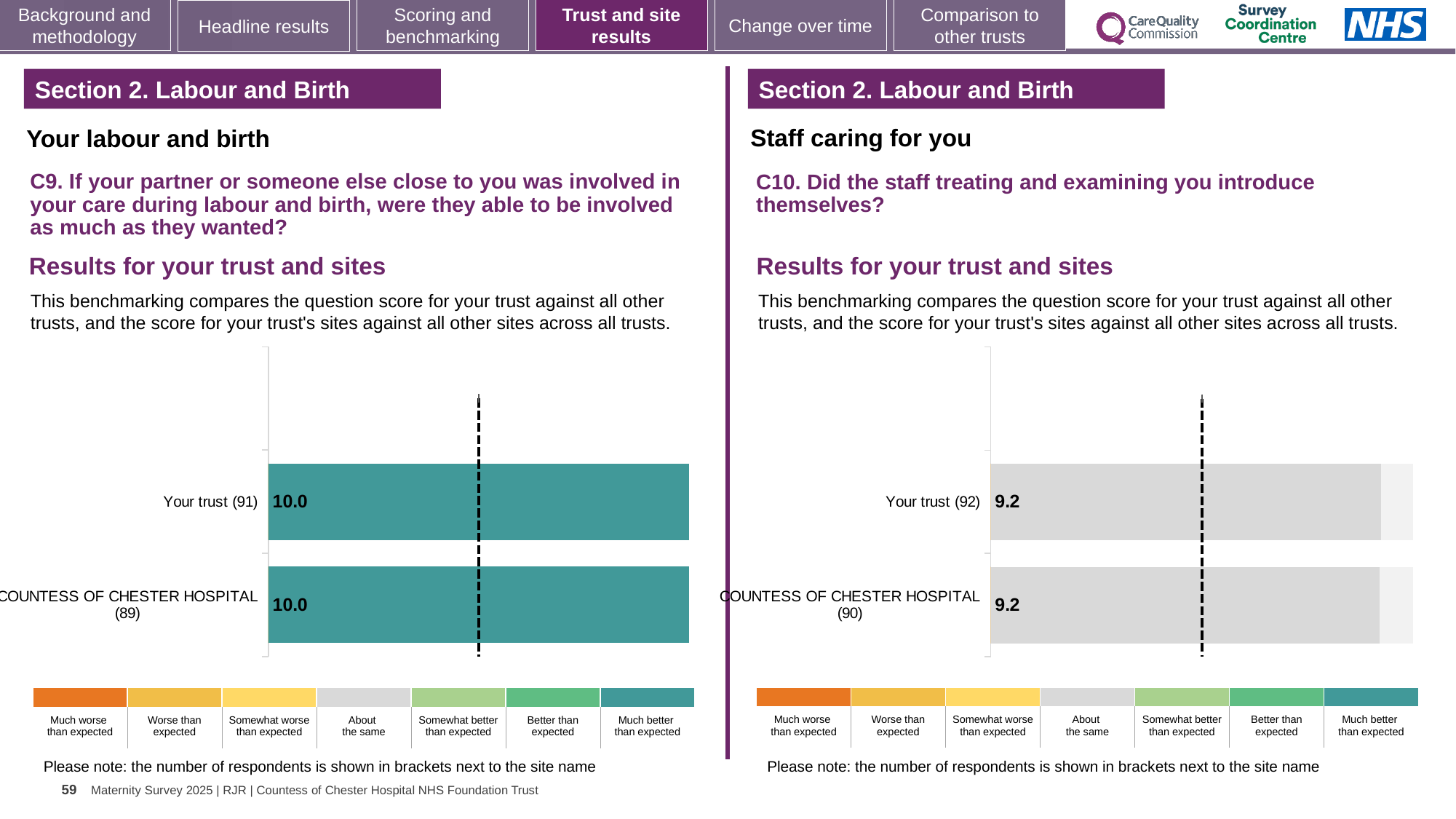
How many bars are plotted on the left chart (C9)? 2 On the left chart (C9), what is the score for COUNTESS OF CHESTER HOSPITAL (89)? 10.0 On the left chart (C9), what is the score for Your trust (91)? 10.0 On the right chart (C10), what is the score for Your trust (92)? 9.2 On the right chart (C10), what is the score for COUNTESS OF CHESTER HOSPITAL (90)? 9.2 On the left chart (C9), which benchmark category does the teal colour of the bars correspond to in the legend? Much better than expected On the right chart (C10), which benchmark category does the grey colour of the bars correspond to in the legend? About the same How many respondents are shown in brackets for Your trust on the right chart (C10)? 92 On the left chart (C9), what is the difference between the score for Your trust and the score for COUNTESS OF CHESTER HOSPITAL? 0.0 On the right chart (C10), what is the difference between the score for Your trust and the score for COUNTESS OF CHESTER HOSPITAL? 0.0 How many bars are plotted on the right chart (C10)? 2 What type of chart is used on the left (C9)? Bar chart